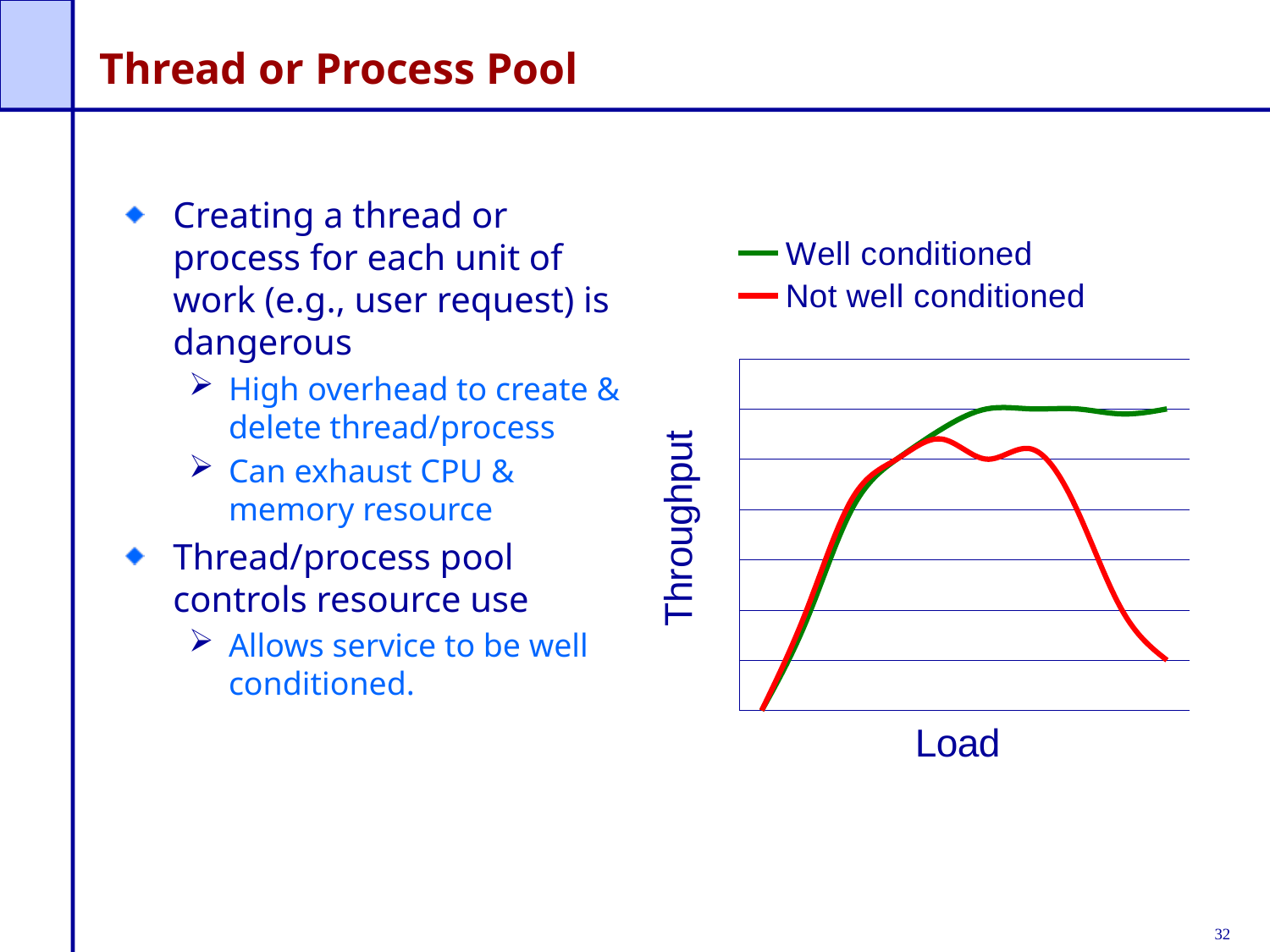
Which series ends at the lowest throughput at the right edge of the chart? Not well conditioned At the right-hand end of the chart (highest load), which series has the higher throughput? Well conditioned Which series reaches the highest throughput on the chart? Well conditioned What kind of chart is shown on the slide? Line chart Does the 'Well conditioned' series level off or drop sharply at high load? Level off What is the label on the chart's horizontal axis? Load Which series is drawn in red? Not well conditioned Does the throughput of the 'Well conditioned' series rise or fall over the left half of the chart as load increases? Rise What are the two series named in the chart's legend? Well conditioned; Not well conditioned How many series does the chart's legend list? 2 Does the throughput of the 'Not well conditioned' series rise or fall as load increases toward the right end of the chart? Fall